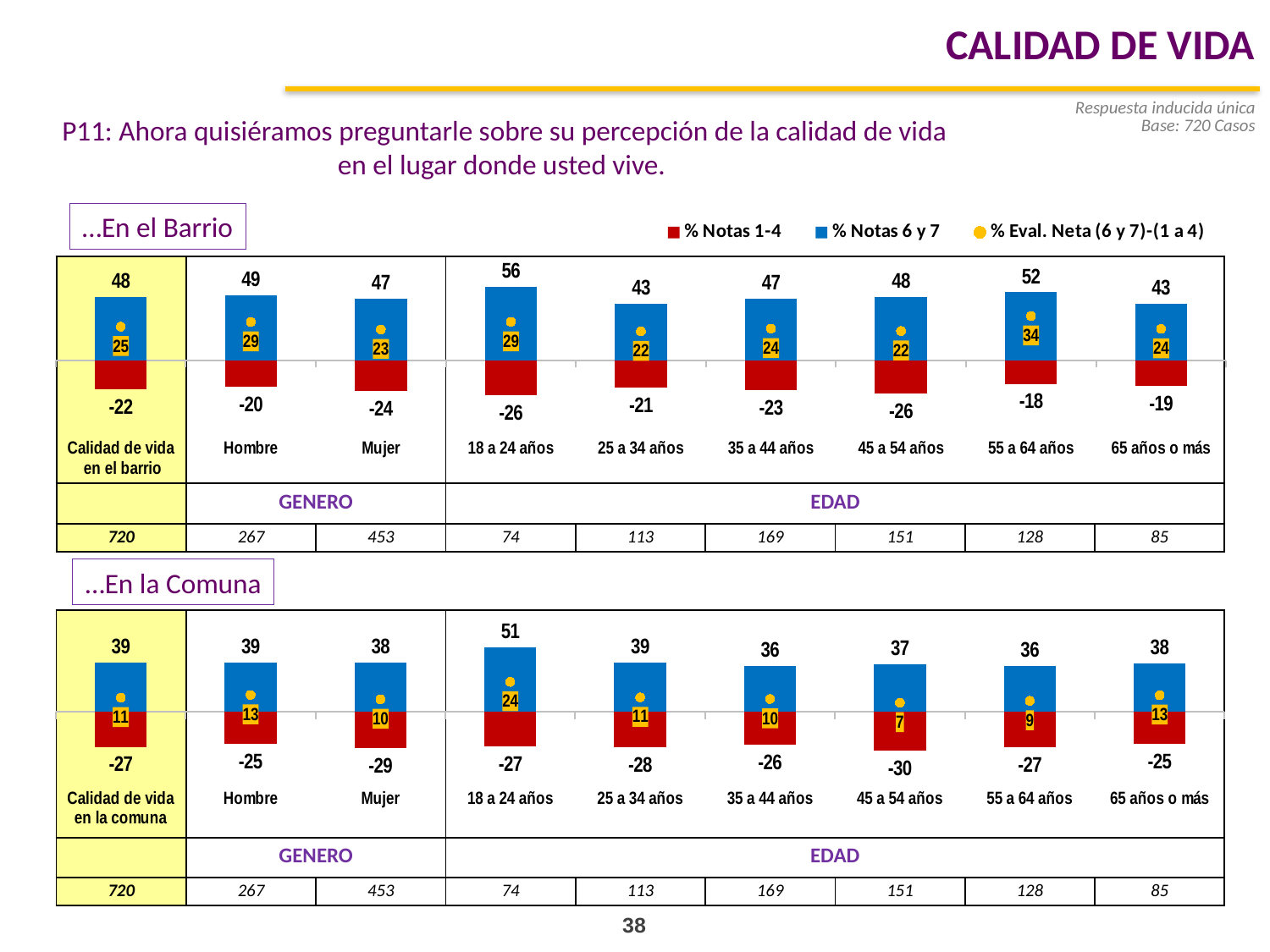
In the "...En el Barrio" chart, what is the % Notas 6 y 7 value for 18 a 24 años? 56 What kind of chart is the "...En el Barrio" chart? Bar chart In the "...En el Barrio" chart, what is the % Notas 1-4 value for Mujer? -24 In the "...En la Comuna" chart, what is the difference between the % Eval. Neta values for Hombre and Mujer? 3 In the "...En la Comuna" chart, is the % Notas 6 y 7 value for Hombre or Mujer larger? Hombre How many series does the legend list for the charts on the slide? 3 In the "...En el Barrio" chart, which age group has the highest % Notas 6 y 7 value? 18 a 24 años In the "...En el Barrio" chart, what is the % Eval. Neta value for 55 a 64 años? 34 In the "...En el Barrio" chart, what is the difference between the % Notas 6 y 7 values for Hombre and Mujer? 2 In the "...En la Comuna" chart, what is the % Notas 1-4 value for 45 a 54 años? -30 In the "...En la Comuna" chart, what is the % Notas 6 y 7 value for 18 a 24 años? 51 In the "...En la Comuna" chart, which age group has the lowest % Eval. Neta value? 45 a 54 años